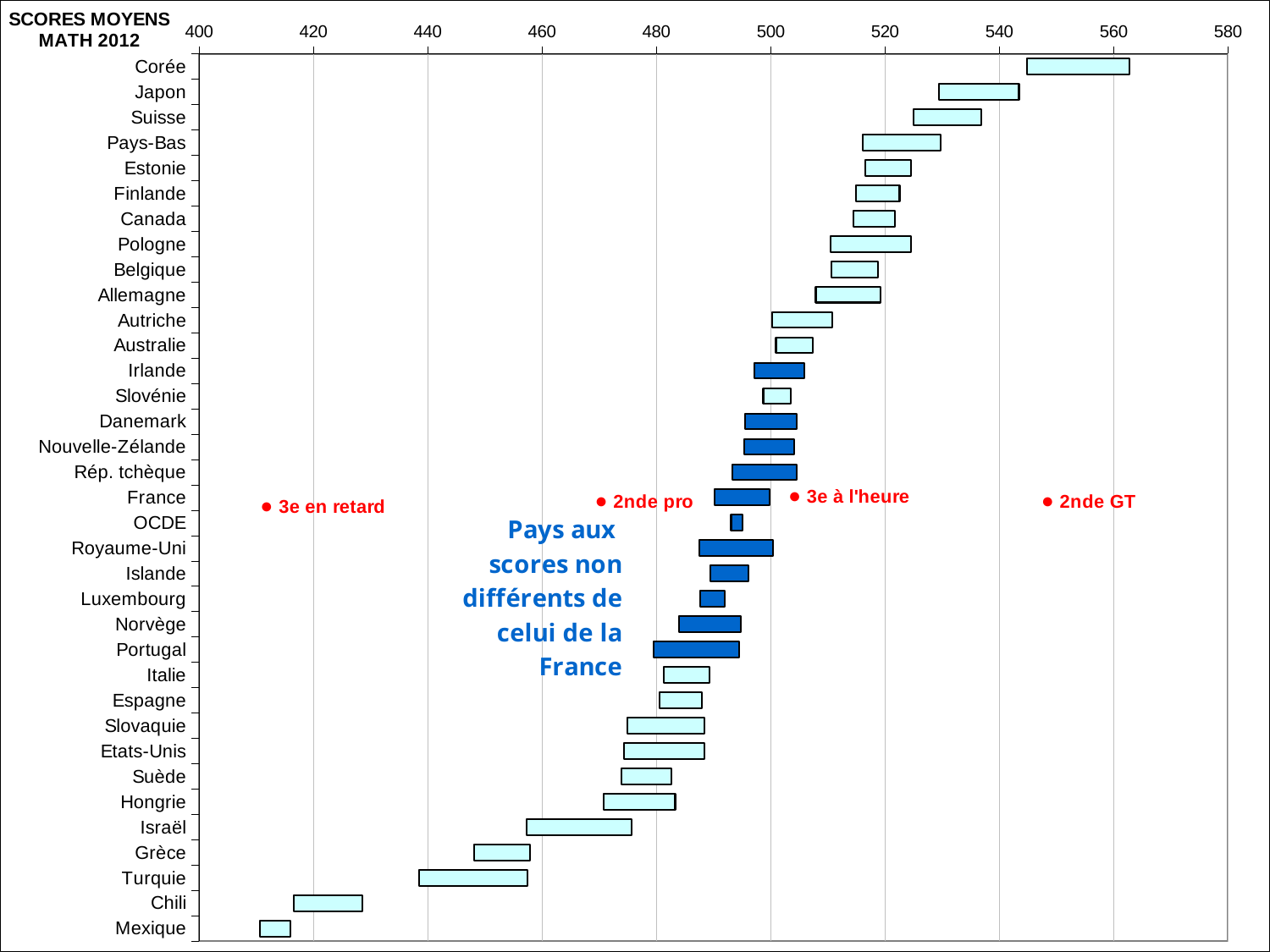
What is the title of the chart? SCORES MOYENS MATH 2012 Is the score for Chili greater or less than 440? less Which has a higher score, Japon or Suisse? Japon What does the blue text in the middle of the chart say the dark blue bars represent? Pays aux scores non différents de celui de la France Do the scores rise or fall going down the list from Corée to Mexique? fall Which country has the highest score range on the chart? Corée Is the score for Corée greater or less than 540? greater Is the score for France greater or less than 520? less What kind of chart is shown on the slide? bar chart Which country has the lowest score range on the chart? Mexique How many countries or entities are listed on the vertical axis of the chart? 35